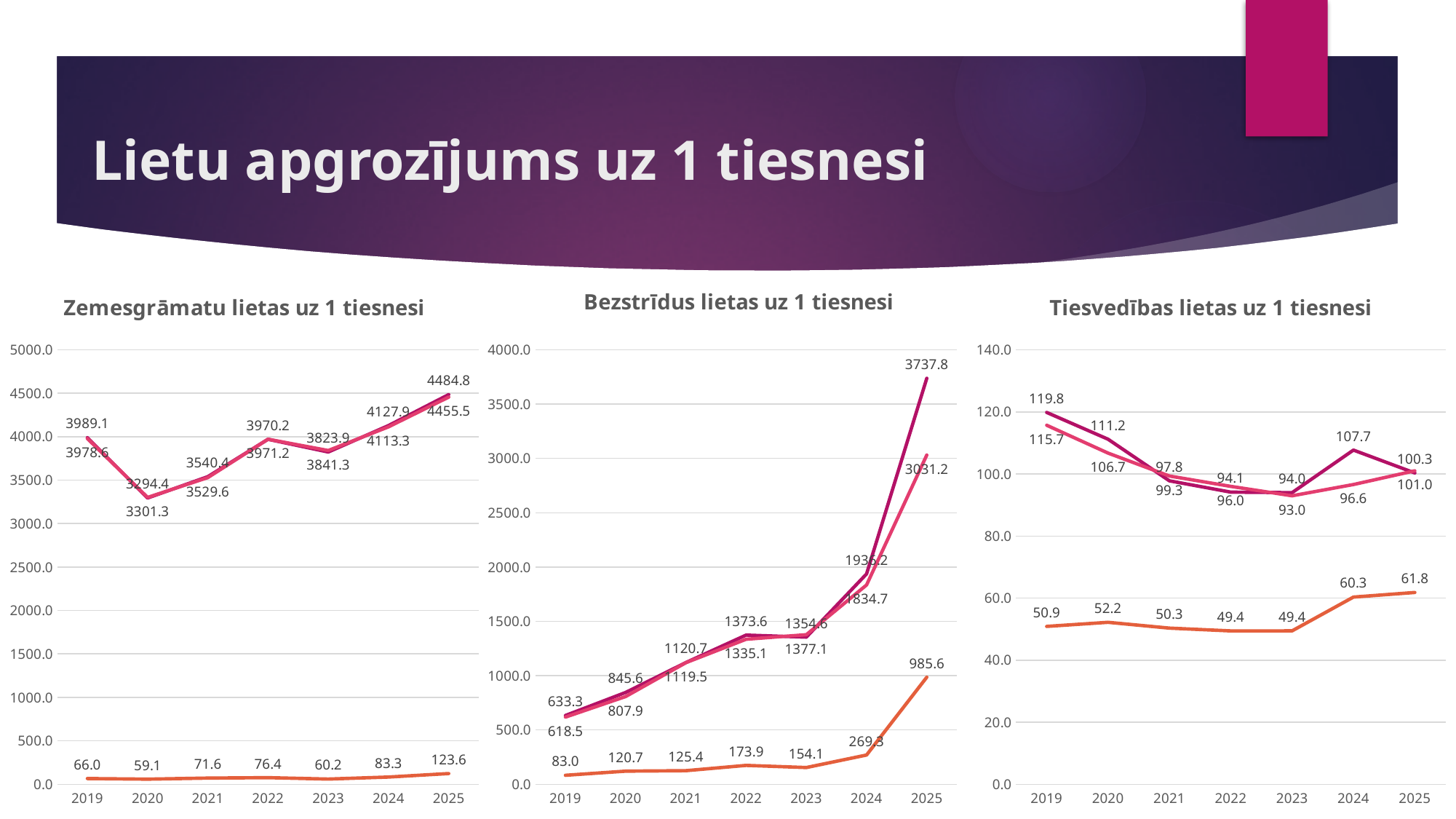
In the "Tiesvedības lietas uz 1 tiesnesi" chart, is the orange line's value larger in 2024 or in 2025? 2025 In the "Zemesgrāmatu lietas uz 1 tiesnesi" chart, in which year is the orange line at its lowest? 2020 In the "Bezstrīdus lietas uz 1 tiesnesi" chart, what is the difference between the orange line's 2025 value and its 2024 value? 716.3 What kind of chart is "Zemesgrāmatu lietas uz 1 tiesnesi"? line chart In the "Tiesvedības lietas uz 1 tiesnesi" chart, how many lines are plotted? 3 In the "Bezstrīdus lietas uz 1 tiesnesi" chart, what is the highest value labelled in 2025? 3737.8 In the "Bezstrīdus lietas uz 1 tiesnesi" chart, how many years are shown on the x axis? 7 In the "Bezstrīdus lietas uz 1 tiesnesi" chart, in which year does the orange line reach its highest value? 2025 In the "Bezstrīdus lietas uz 1 tiesnesi" chart, is the highest 2025 value greater or less than 3500? greater In the "Zemesgrāmatu lietas uz 1 tiesnesi" chart, what is the value of the orange line in 2025? 123.6 How many charts are shown on the slide? 3 In the "Tiesvedības lietas uz 1 tiesnesi" chart, what is the value of the orange line in 2019? 50.9